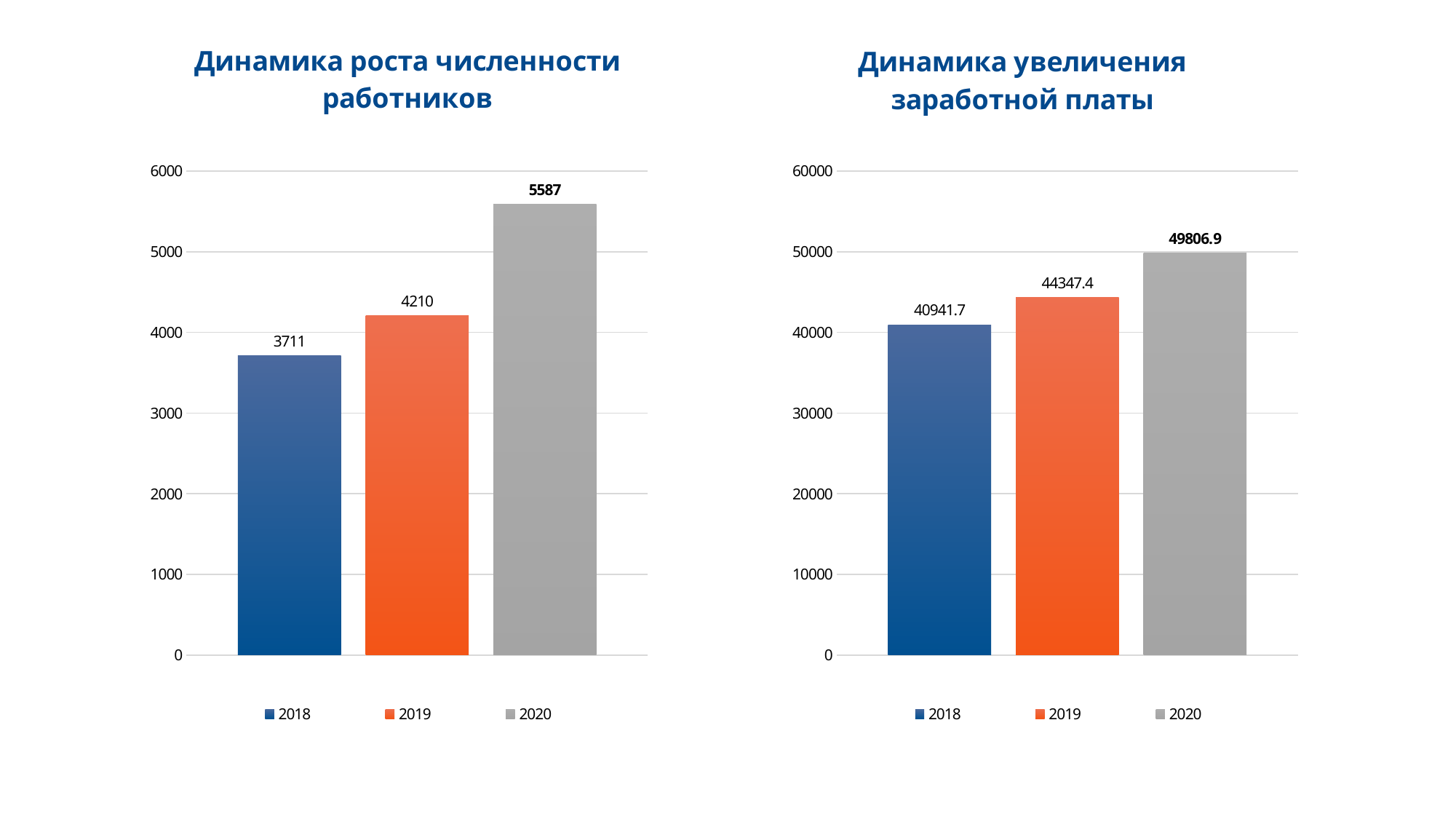
In the chart 'Динамика роста численности работников', what is the value for 2020? 5587 How many bars are plotted in the chart 'Динамика роста численности работников'? 3 In the chart 'Динамика увеличения заработной платы', what is the value for 2019? 44347.4 In the chart 'Динамика увеличения заработной платы', what is the value for 2020? 49806.9 In the chart 'Динамика роста численности работников', which is larger, the value for 2019 or the value for 2018? 2019 In the chart 'Динамика увеличения заработной платы', which year has the lowest value? 2018 In the chart 'Динамика увеличения заработной платы', is the value for 2020 greater or less than 50000? less In the chart 'Динамика увеличения заработной платы', what is the difference between the 2019 and 2018 values? 3405.7 In the chart 'Динамика роста численности работников', which year has the highest value? 2020 In the chart 'Динамика роста численности работников', what is the difference between the 2020 and 2018 values? 1876 In the chart 'Динамика роста численности работников', what is the value for 2018? 3711 What kind of chart is 'Динамика увеличения заработной платы'? bar chart